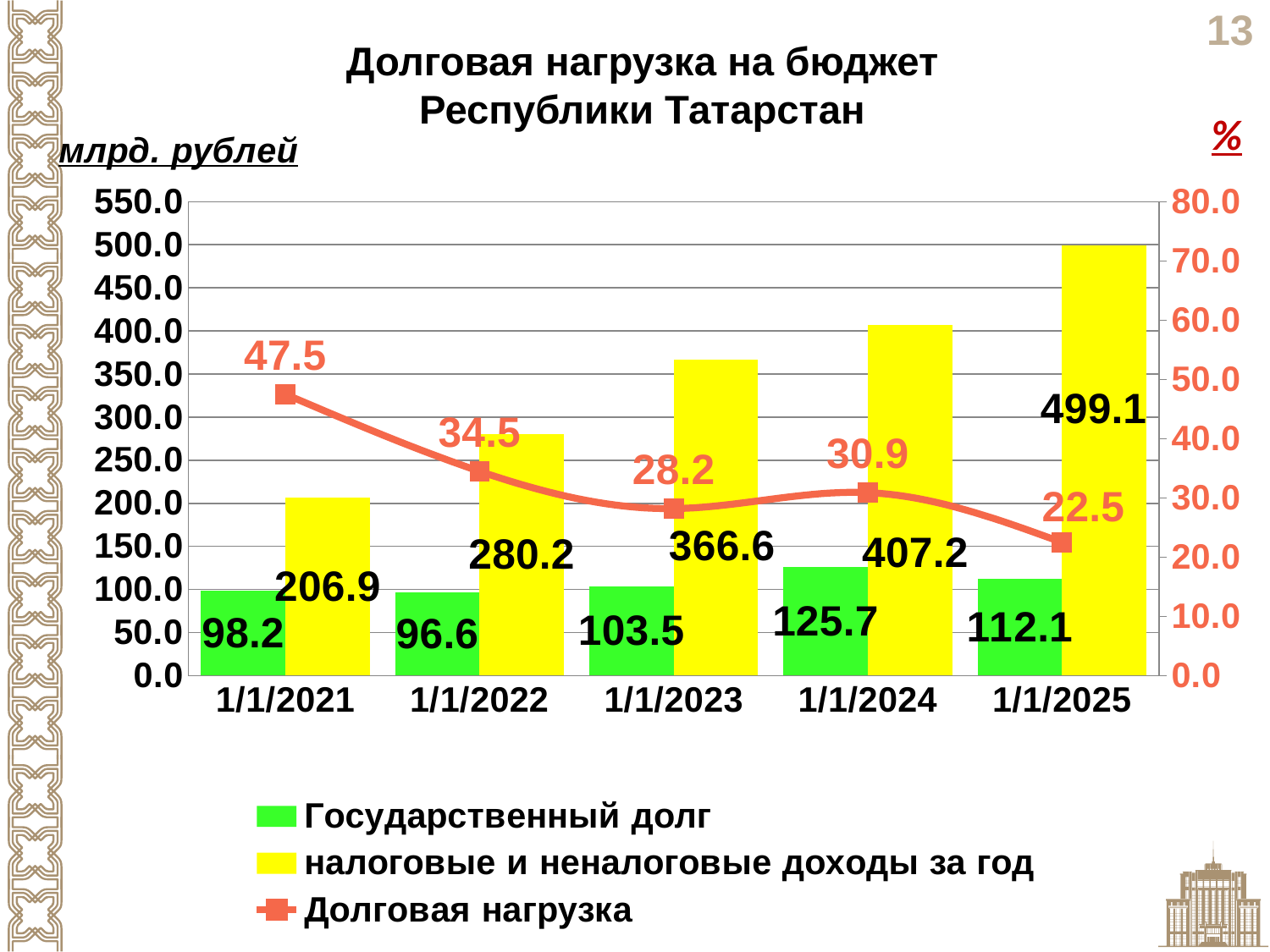
Which is larger: Государственный долг on 1/1/2023 or on 1/1/2025? 1/1/2025 How many series does the legend list? 3 What is the value of Государственный долг on 1/1/2024? 125.7 What is the Долговая нагрузка value on 1/1/2021? 47.5 Which series is shown in yellow? налоговые и неналоговые доходы за год What is the value of налоговые и неналоговые доходы за год on 1/1/2025? 499.1 In which year is Государственный долг the lowest? 1/1/2022 Does Долговая нагрузка rise or fall from 1/1/2021 to 1/1/2023? fall How many dates are shown on the x axis? 5 What is the title of the chart? Долговая нагрузка на бюджет Республики Татарстан In which year is Долговая нагрузка the highest? 1/1/2021 What is the difference between налоговые и неналоговые доходы за год on 1/1/2025 and on 1/1/2024? 91.9